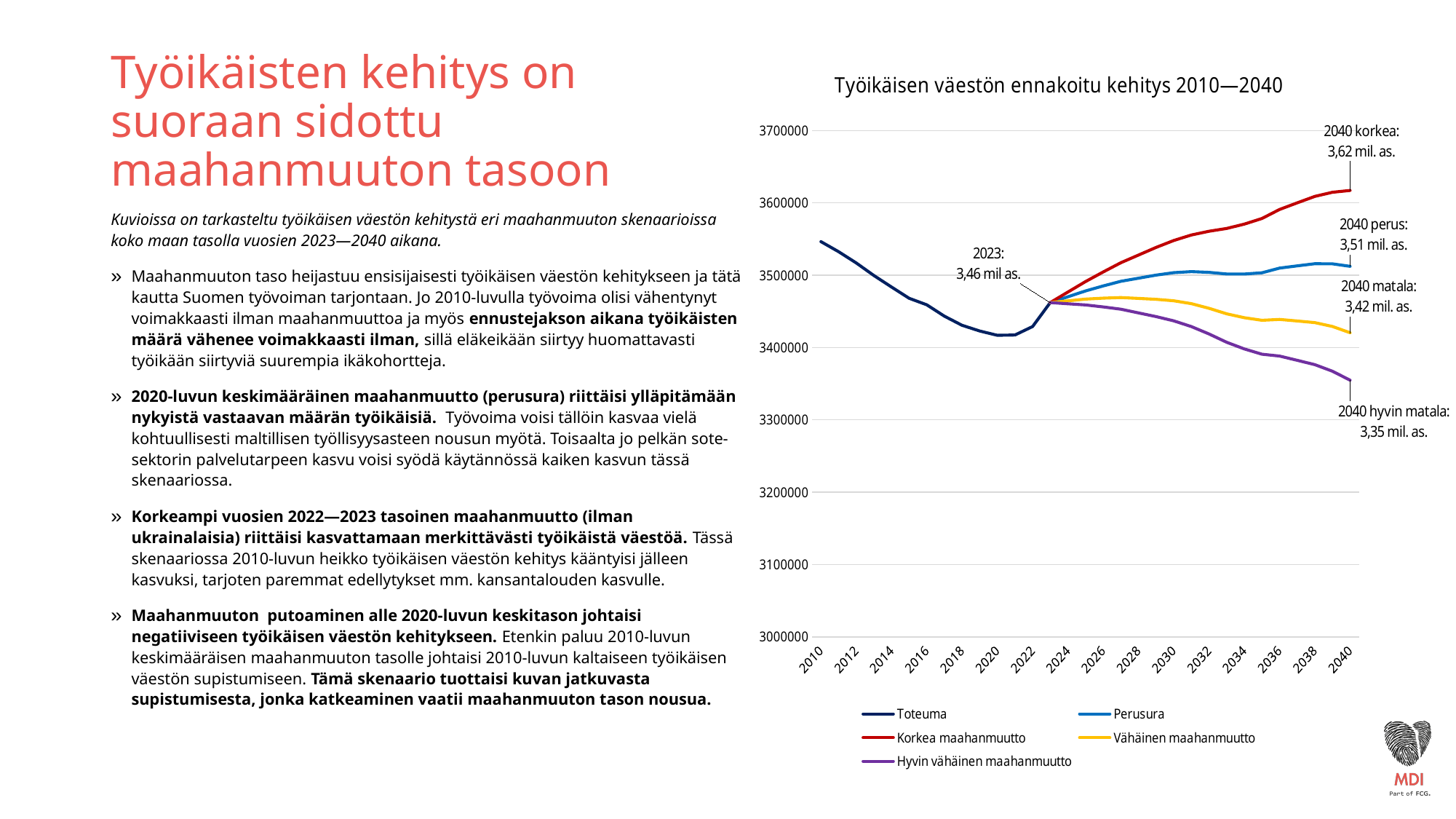
What value is labelled for 2023 on the chart? 3,46 mil. as. What value is labelled for the 'perus' scenario in 2040? 3,51 mil. as. What value is labelled for the 'matala' scenario in 2040? 3,42 mil. as. Does the Toteuma line rise or fall between 2010 and 2020? fall Which series has the lowest value in 2040? Hyvin vähäinen maahanmuutto How many series does the legend of the chart list? 5 What kind of chart is shown on the slide? line chart What is the title of the chart? Työikäisen väestön ennakoitu kehitys 2010—2040 What is the difference between the 2040 'korkea' value and the 2040 'hyvin matala' value? 0,27 mil. as. What value is labelled for the 'hyvin matala' scenario in 2040? 3,35 mil. as. Which series has the highest value in 2040? Korkea maahanmuutto What value is labelled for the 'korkea' scenario in 2040? 3,62 mil. as.